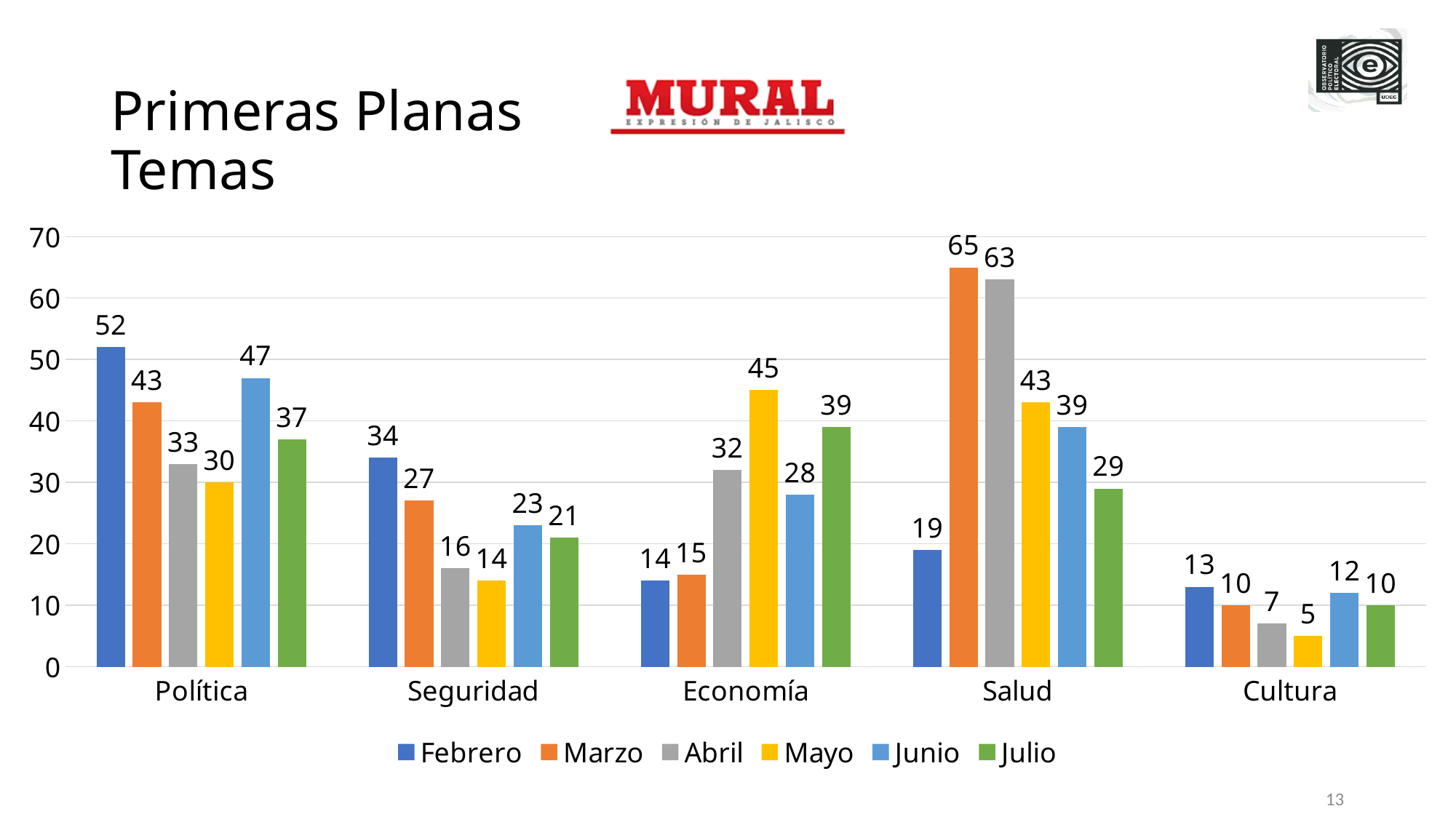
Which month has the highest value in the Cultura category? Febrero What is the value for Marzo in the Salud category? 65 Which month has the lowest value in the Seguridad category? Mayo What kind of chart is shown on the slide? Bar chart What is the value for Mayo in the Economía category? 45 What is the value for Junio in the Política category? 47 How many series does the legend list? 6 How many categories are shown on the x axis? 5 Which is larger in the Economía category, the Abril value or the Julio value? Julio What is the difference between the Febrero and Mayo values in the Política category? 22 Which colour represents Mayo in the legend? Yellow What is the difference between the Marzo and Febrero values in the Salud category? 46